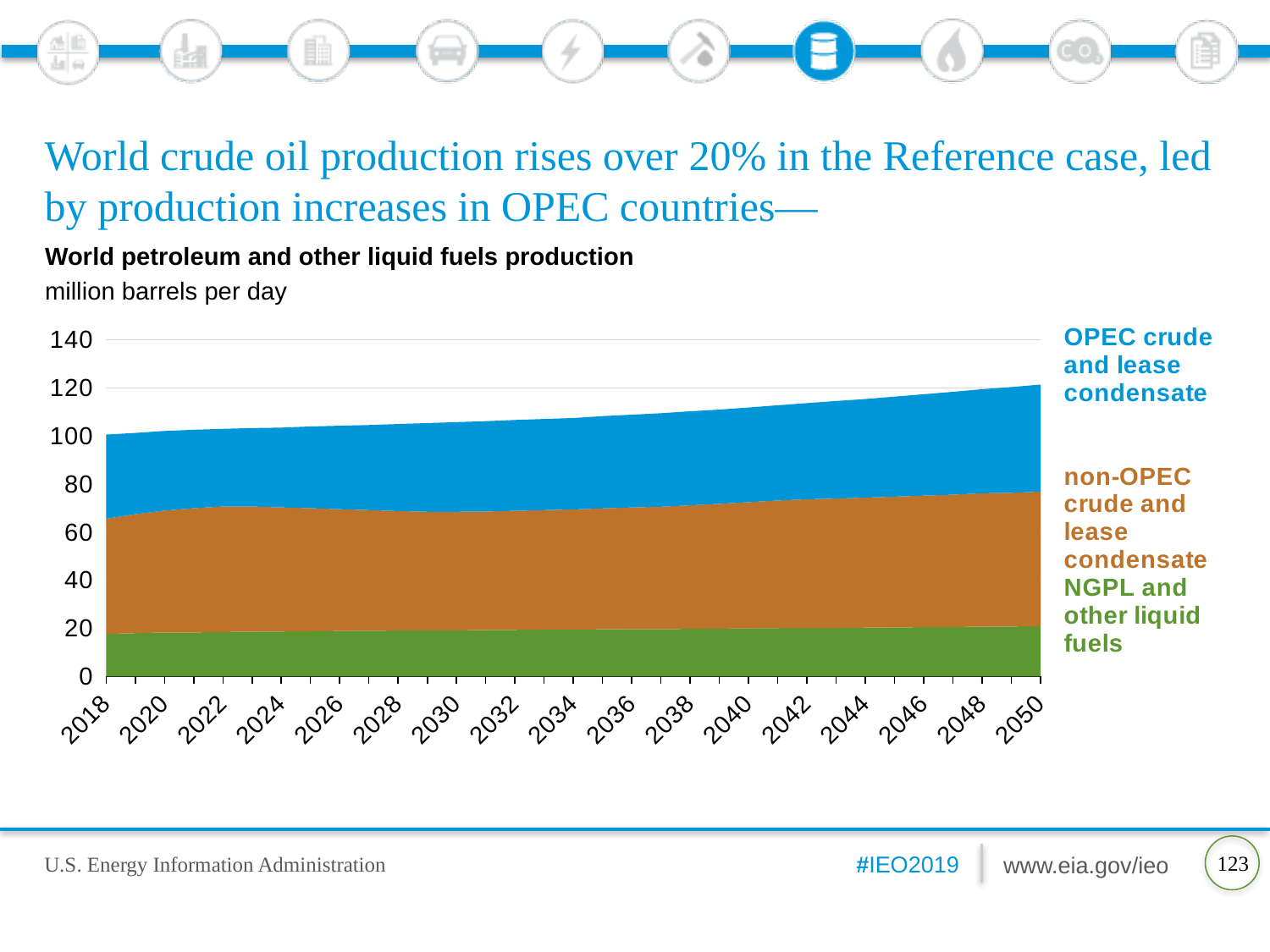
Which series is plotted at the bottom of the stack? NGPL and other liquid fuels How many year labels are shown on the x axis? 17 Is the total production in 2018 greater or less than 80 million barrels per day? greater Is the NGPL and other liquid fuels layer in 2030 greater or less than 40 million barrels per day? less Does total world petroleum and other liquid fuels production rise or fall from 2018 to 2050? rise What is the unit of measurement shown for the chart? million barrels per day What kind of chart is shown on the slide? Stacked area chart Is the top of the non-OPEC crude and lease condensate layer in 2018 greater or less than 60 million barrels per day? greater What is the title of the chart? World petroleum and other liquid fuels production How many series does the chart show? 3